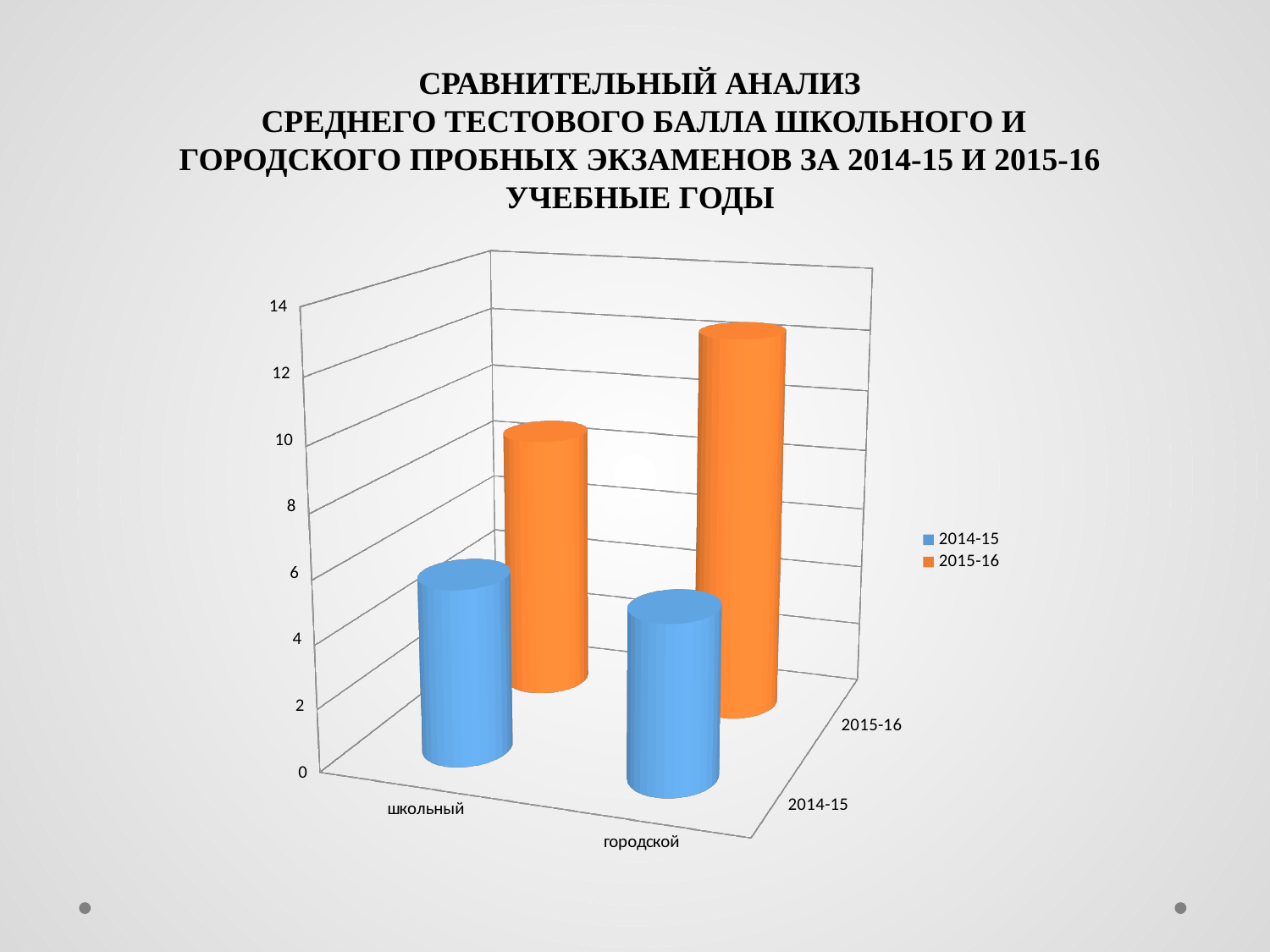
What colour are the bars for the 2015-16 series? orange In the 2015-16 series, do the values rise or fall from школьный to городской? rise How many categories are shown on the x axis of the chart? 2 Is the value for школьный in the 2014-15 series greater or less than 8? less Is the value for городской in the 2014-15 series greater or less than 10? less Is the value for городской in the 2015-16 series greater or less than 8? greater In the 2015-16 series, which category has the larger value: школьный or городской? городской What kind of chart is shown on the slide? bar chart Which series and category has the highest bar in the chart? 2015-16, городской For the category школьный, which series has the larger value: 2014-15 or 2015-16? 2015-16 For the category городской, which series has the larger value: 2014-15 or 2015-16? 2015-16 How many series does the legend list? 2